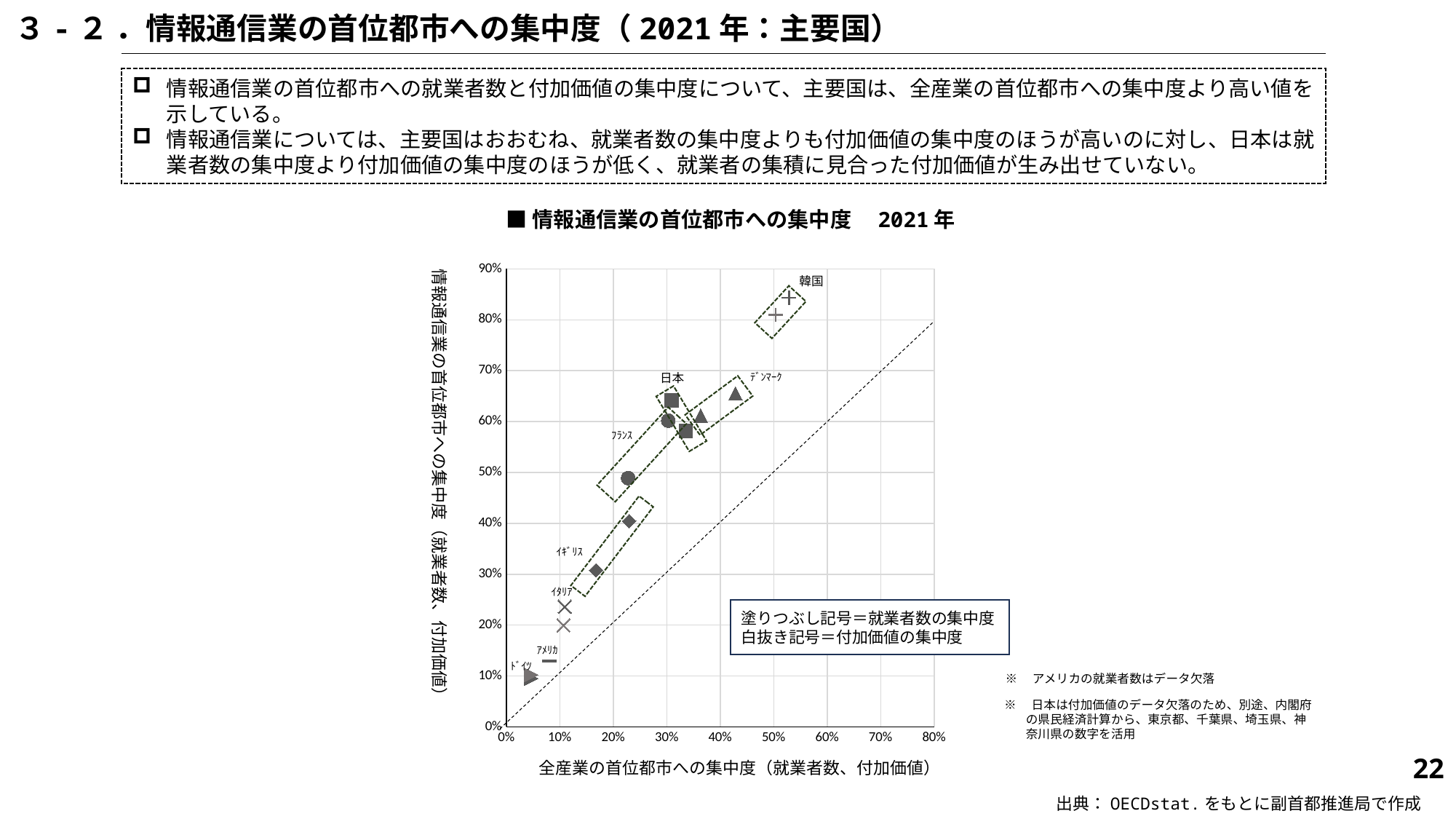
Which country has the highest y-axis values on the chart? 韓国 Is the y-axis value for 韓国's filled marker greater or less than 70%? greater What is the title of the chart? 情報通信業の首位都市への集中度 2021年 Is the y-axis value for 日本's filled marker greater or less than 60%? greater Is the y-axis value for イタリア's filled marker greater or less than 30%? less Do the plotted points generally rise or fall as the x-axis value increases? rise How many countries are labelled on the chart? 8 According to the legend box, what do the filled markers represent? 就業者数の集中度 What kind of chart is shown on the slide? scatter chart For 日本, which marker is higher on the y axis, the filled marker or the open marker? filled marker